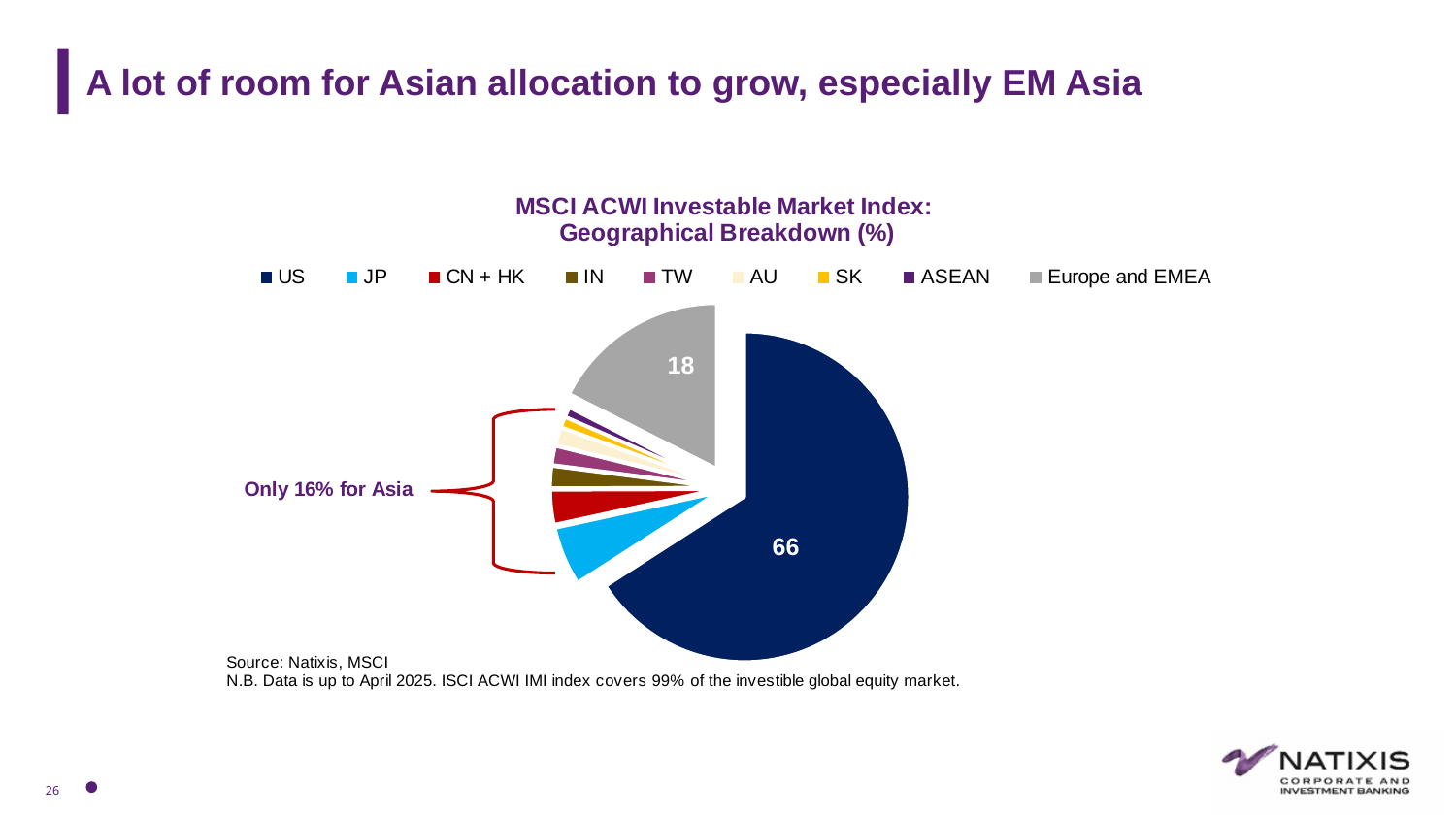
Which is larger in the pie chart, the Europe and EMEA slice or the JP slice? Europe and EMEA What kind of chart is shown on the slide? Pie chart What is the title of the chart on the slide? MSCI ACWI Investable Market Index: Geographical Breakdown (%) Which is larger in the pie chart, the US slice or the Europe and EMEA slice? US How many entries does the legend of the pie chart list? 9 According to the annotation next to the pie chart, what share of the index is allocated to Asia? Only 16% for Asia What is the value for Europe and EMEA in the pie chart? 18 Which is larger in the pie chart, the JP slice or the CN + HK slice? JP What is the difference between the US value and the Europe and EMEA value in the pie chart? 48 What is the value for US in the MSCI ACWI Investable Market Index geographical breakdown pie chart? 66 Which category has the largest slice in the pie chart? US How many categories does the pie chart show? 9